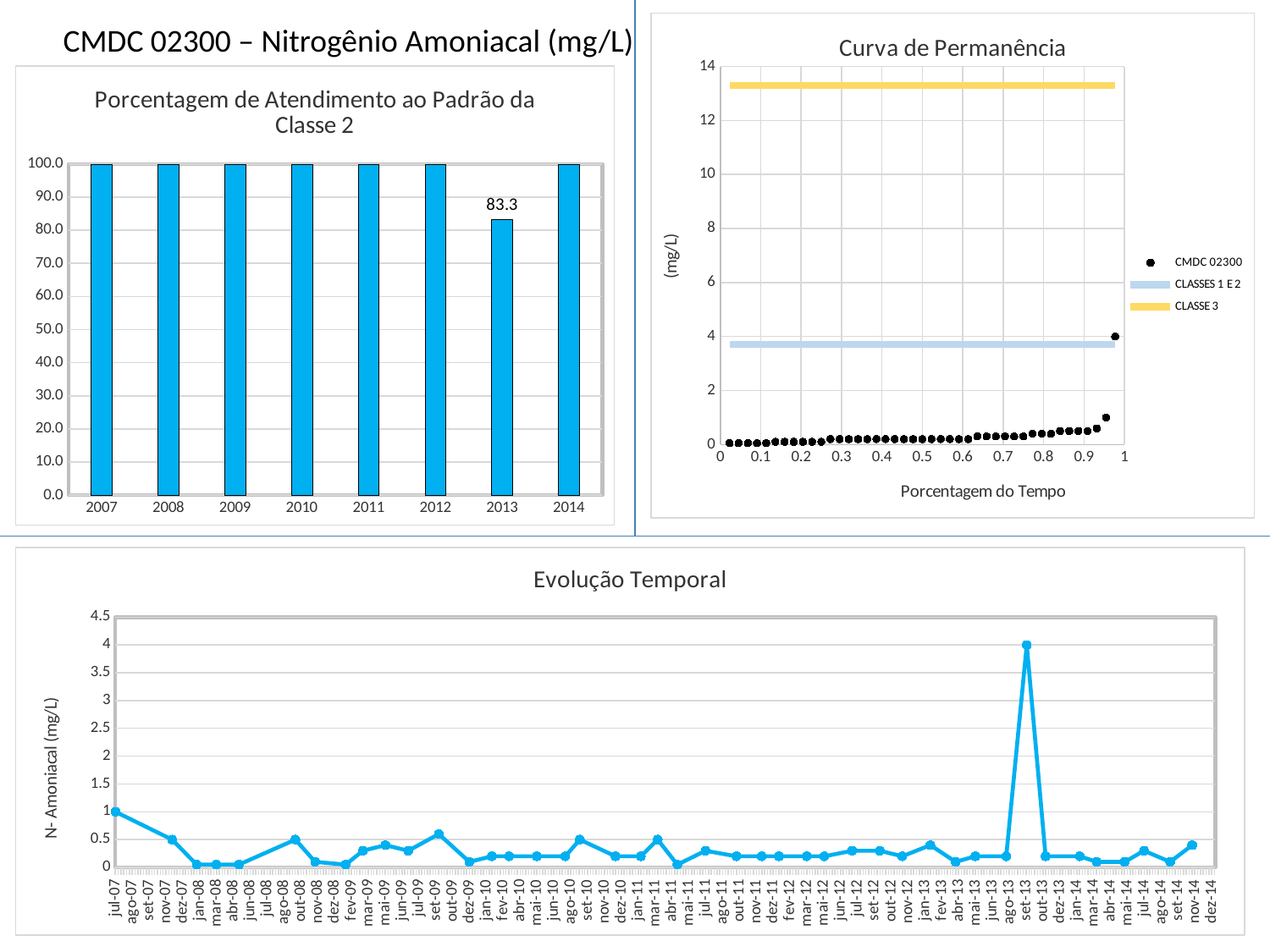
In the 'Curva de Permanência' chart, is the CLASSES 1 E 2 line greater or less than 4? less How many series does the legend of the 'Curva de Permanência' chart list? 3 In the 'Porcentagem de Atendimento ao Padrão da Classe 2' chart, which year has the lowest value? 2013 What kind of chart is 'Porcentagem de Atendimento ao Padrão da Classe 2'? bar chart In the 'Evolução Temporal' chart, which month has the highest value? set-13 How many years are shown in the 'Porcentagem de Atendimento ao Padrão da Classe 2' chart? 8 In the 'Porcentagem de Atendimento ao Padrão da Classe 2' chart, which is larger, the value for 2012 or the value for 2013? 2012 In the 'Porcentagem de Atendimento ao Padrão da Classe 2' chart, what is the value for 2010? 100.0 In the 'Curva de Permanência' chart, is the CLASSE 3 line greater or less than 12? greater In the 'Porcentagem de Atendimento ao Padrão da Classe 2' chart, what is the value for 2013? 83.3 In the 'Evolução Temporal' chart, is the value for set-13 greater or less than 3.5? greater